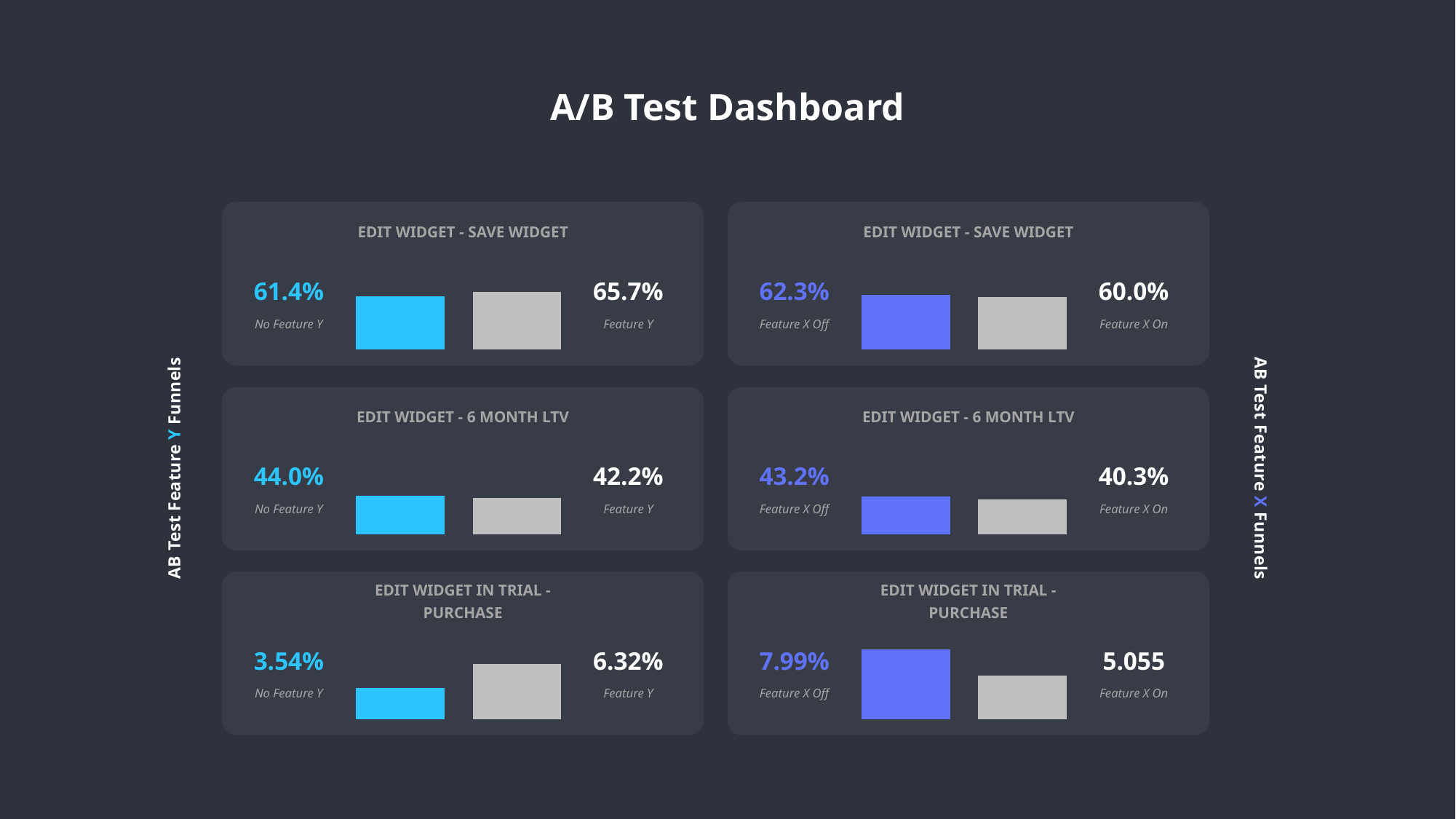
What kind of chart is the Feature Y 'Edit Widget - Save Widget' chart on the left? Bar chart How many charts are shown on the slide? 6 In the Feature Y 'Edit Widget - Save Widget' chart on the left, what is the difference between Feature Y and No Feature Y? 4.3 percentage points In the Feature Y 'Edit Widget in Trial - Purchase' chart on the left, what is the value for Feature Y? 6.32% In the Feature X 'Edit Widget - 6 Month LTV' chart on the right, what is the difference between Feature X Off and Feature X On? 2.9 percentage points In the Feature X 'Edit Widget - 6 Month LTV' chart on the right, what is the value for Feature X On? 40.3% In the Feature X 'Edit Widget - Save Widget' chart on the right, what is the value for Feature X Off? 62.3% In the Feature Y 'Edit Widget - Save Widget' chart on the left, what is the value for Feature Y? 65.7% In the Feature Y 'Edit Widget - 6 Month LTV' chart on the left, which is larger: No Feature Y or Feature Y? No Feature Y In the Feature X 'Edit Widget - Save Widget' chart on the right, which is larger: Feature X Off or Feature X On? Feature X Off In the Feature X 'Edit Widget in Trial - Purchase' chart on the right, what is the value for Feature X Off? 7.99% In the Feature Y 'Edit Widget - Save Widget' chart on the left, what is the value for No Feature Y? 61.4%